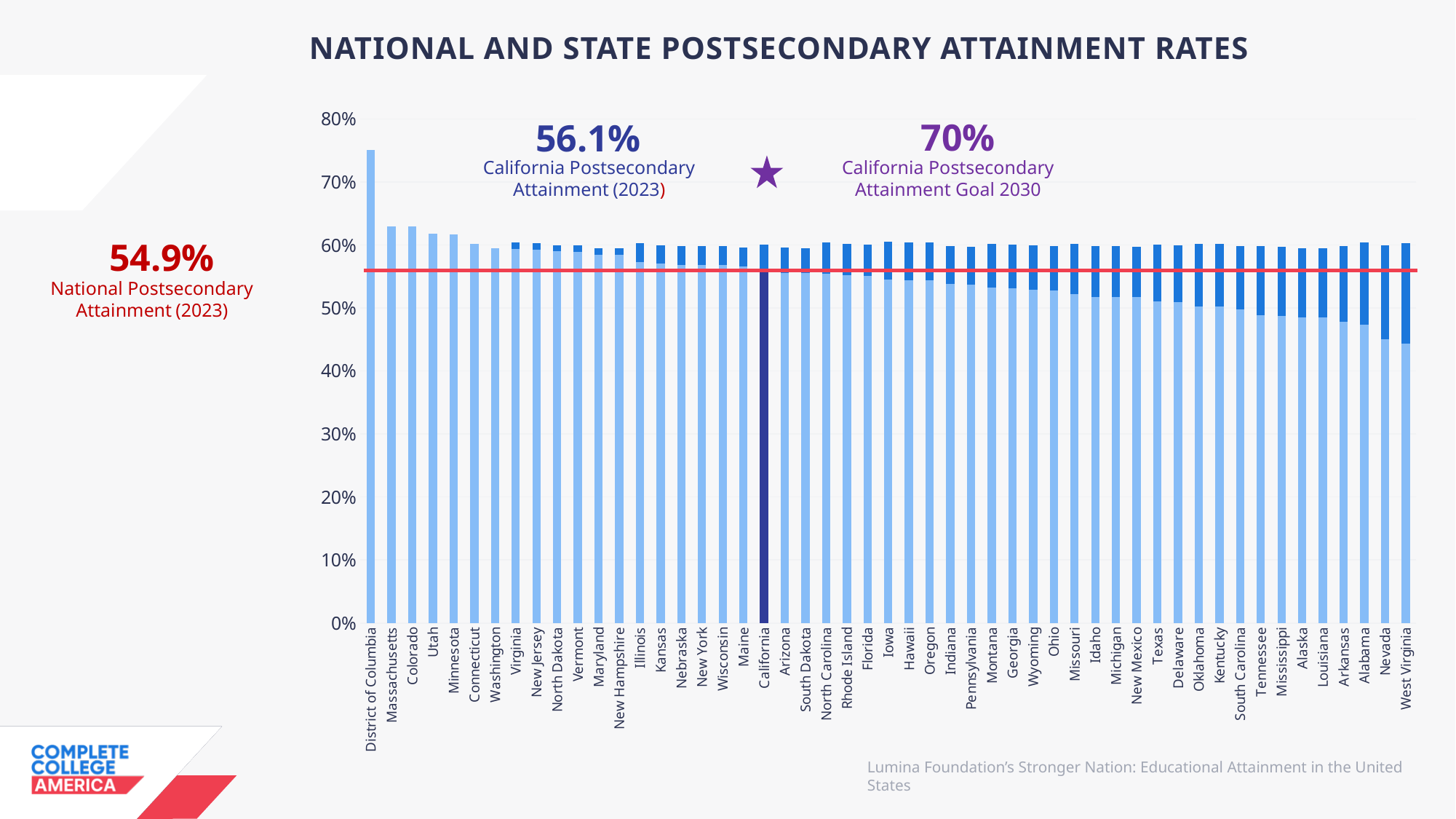
What is the title of the chart? National and State Postsecondary Attainment Rates Is the attainment rate for West Virginia greater or less than 50%? less How many states and districts are plotted as bars in the chart? 51 Which state or district has the highest postsecondary attainment rate in the chart? District of Columbia Is the attainment rate for District of Columbia greater or less than 70%? greater How many percentage points must California's attainment rise from its 2023 rate to reach its 2030 goal? 13.9 percentage points By how many percentage points does California's 2023 attainment rate exceed the national 2023 rate? 1.2 percentage points What is the national postsecondary attainment rate for 2023? 54.9% What is California's postsecondary attainment rate for 2023? 56.1% What is California's postsecondary attainment goal for 2030? 70% Which state has the lowest postsecondary attainment rate in the chart? West Virginia What kind of chart is shown on the slide? bar chart